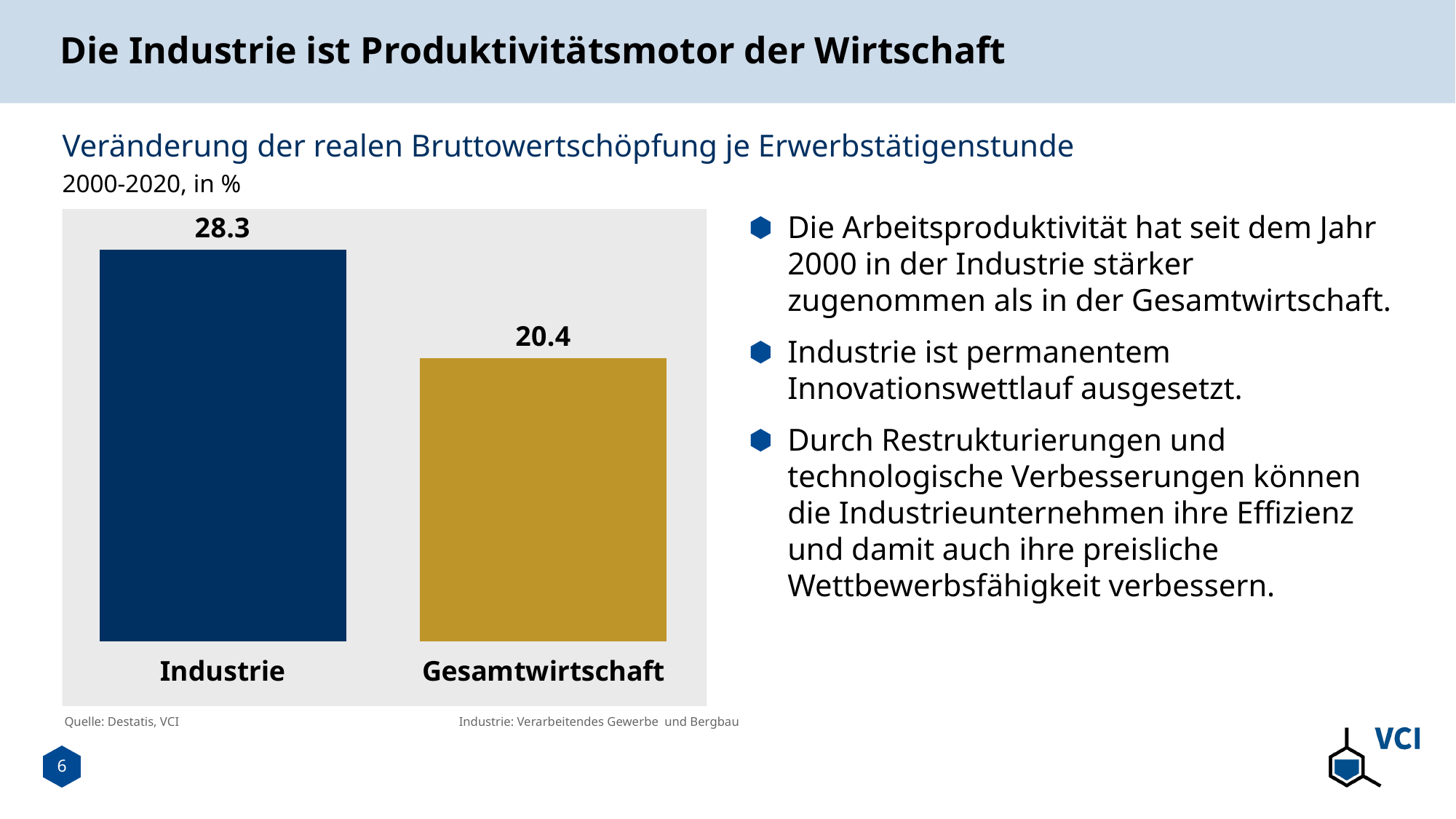
What period and unit does the chart subtitle indicate? 2000-2020, in % Which category has the highest value? Industrie What is the title of the chart? Veränderung der realen Bruttowertschöpfung je Erwerbstätigenstunde How many categories are shown in the chart? 2 Which category has the lowest value? Gesamtwirtschaft What is the value for Industrie? 28.3 What is the value for Gesamtwirtschaft? 20.4 What is the source given for the chart? Destatis, VCI Which is larger, the value for Industrie or the value for Gesamtwirtschaft? Industrie What is the difference between the values for Industrie and Gesamtwirtschaft? 7.9 What kind of chart is shown on the slide? Bar chart